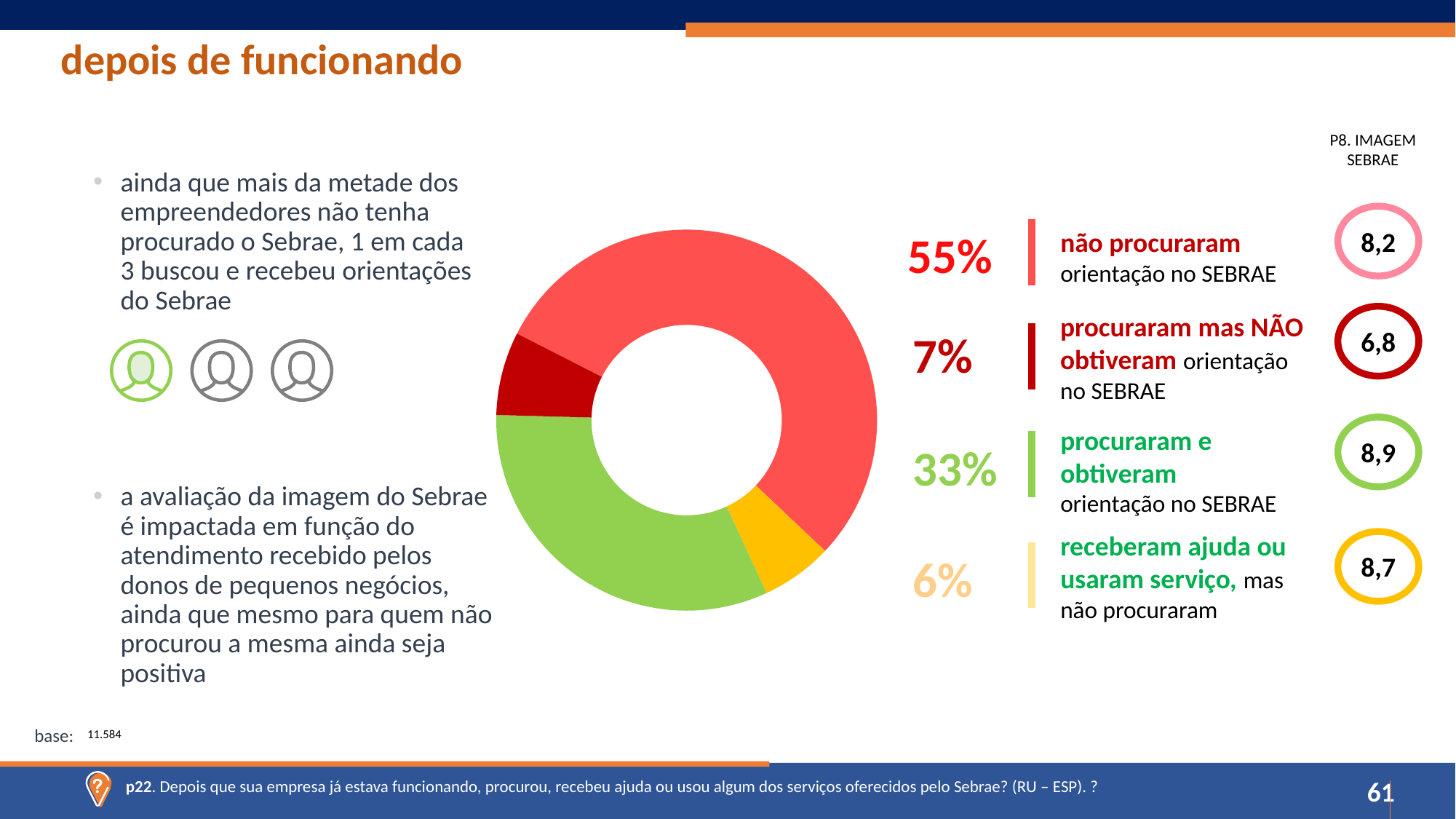
What percentage of respondents did not seek (não procuraram) guidance at SEBRAE? 55% What is the P8 image score (IMAGEM SEBRAE) for those who sought and obtained guidance (procuraram e obtiveram)? 8,9 Which category has the largest share of the donut chart? não procuraram orientação no SEBRAE Which is larger: the share for 'procuraram mas NÃO obtiveram' or the share for 'receberam ajuda ou usaram serviço, mas não procuraram'? procuraram mas NÃO obtiveram How many categories (slices) does the donut chart have? 4 What percentage sought but did NOT obtain (procuraram mas NÃO obtiveram) guidance at SEBRAE? 7% What colour is the slice representing 'procuraram e obtiveram orientação no SEBRAE'? Green What percentage received help or used a service but did not seek it (receberam ajuda ou usaram serviço, mas não procuraram)? 6% What percentage sought and obtained (procuraram e obtiveram) guidance at SEBRAE? 33% Which category has the smallest share of the donut chart? receberam ajuda ou usaram serviço, mas não procuraram What kind of chart is shown on the slide? Donut (pie) chart What is the difference in percentage points between 'não procuraram' and 'procuraram e obtiveram'? 22 percentage points